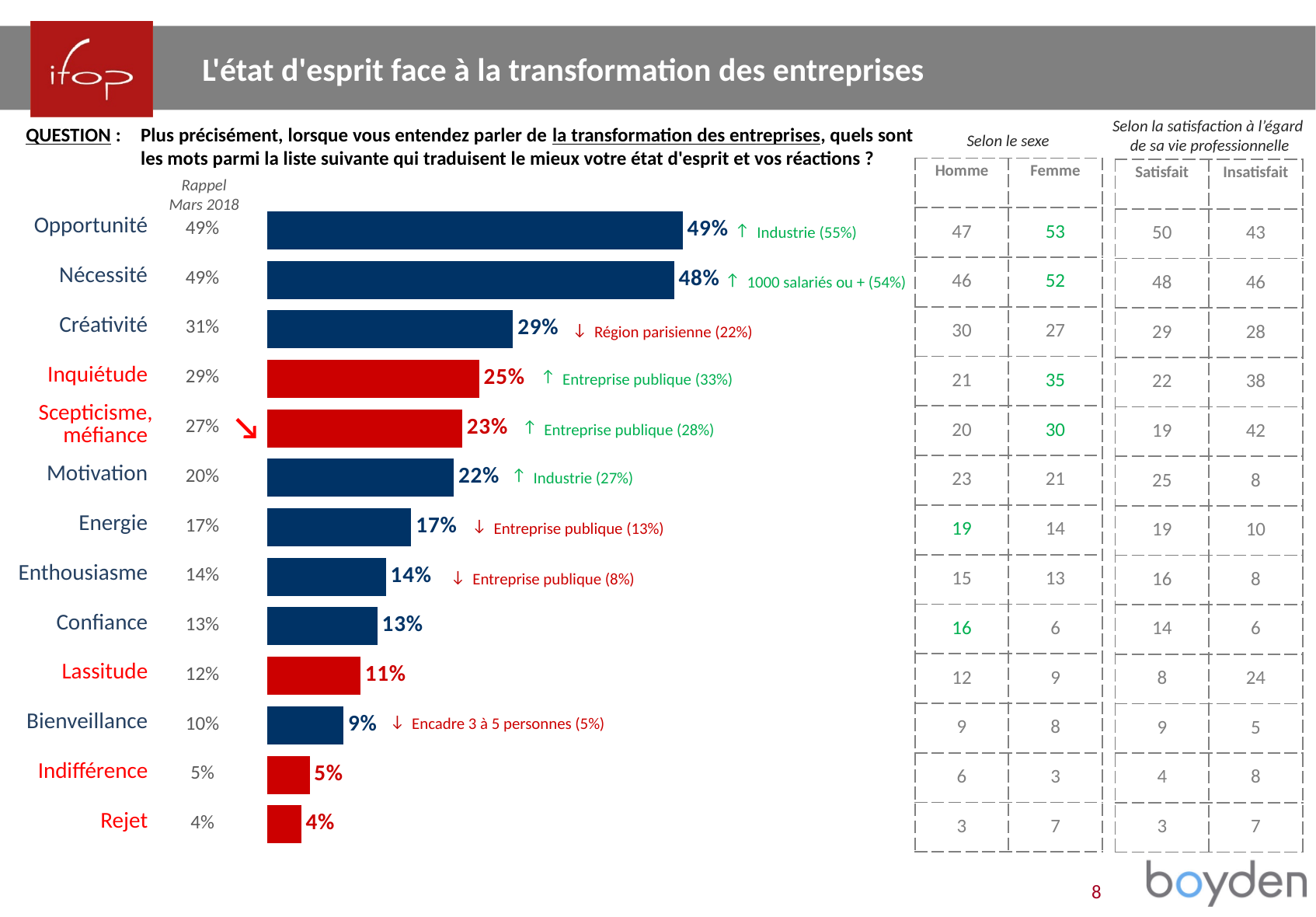
What is the value for Scepticisme, méfiance? 23% What is the difference between the values for Opportunité and Nécessité? 1 point What colour are the bars for Inquiétude, Lassitude, Indifférence and Rejet? red Which category has the lowest value? Rejet What kind of chart is shown on the slide? bar chart Which category has the highest value? Opportunité How many categories are shown in the bar chart? 13 What is the value for Opportunité? 49% What is the value for Bienveillance? 9% What is the difference between the values for Inquiétude and Lassitude? 14 points What was the Rappel Mars 2018 value for Créativité? 31% Which is larger, the value for Inquiétude or the value for Motivation? Inquiétude